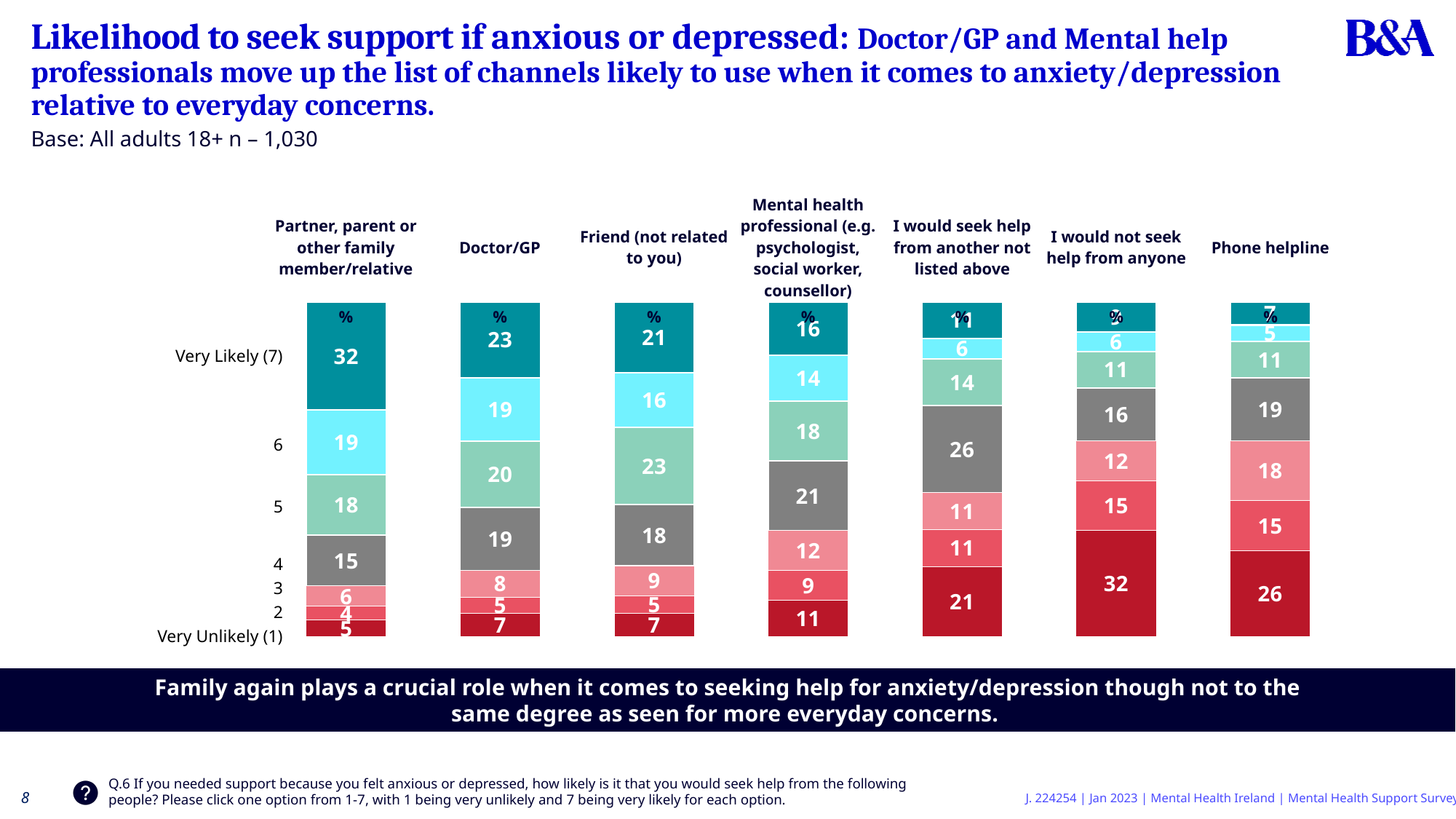
What is the difference between the Very Likely (7) percentages for partner/family and Doctor/GP? 9 What is the Very Unlikely (1) value for 'I would not seek help from anyone'? 32 What percentage are Very Likely (7) to seek help from a partner, parent or other family member/relative? 32 What percentage are Very Likely (7) to seek help from a mental health professional? 16 What kind of chart is shown on the slide? Stacked bar chart What percentage gave a rating of 4 for 'I would seek help from another not listed above'? 26 What is the base stated for the chart? All adults 18+ n – 1,030 Which has a higher Very Likely (7) percentage: Doctor/GP or Friend (not related to you)? Doctor/GP What percentage are Very Likely (7) to seek help from a Doctor/GP? 23 Which channel has the highest Very Likely (7) percentage? Partner, parent or other family member/relative What percentage are Very Unlikely (1) to seek help from a phone helpline? 26 How many channels (bars) are shown in the chart? 7